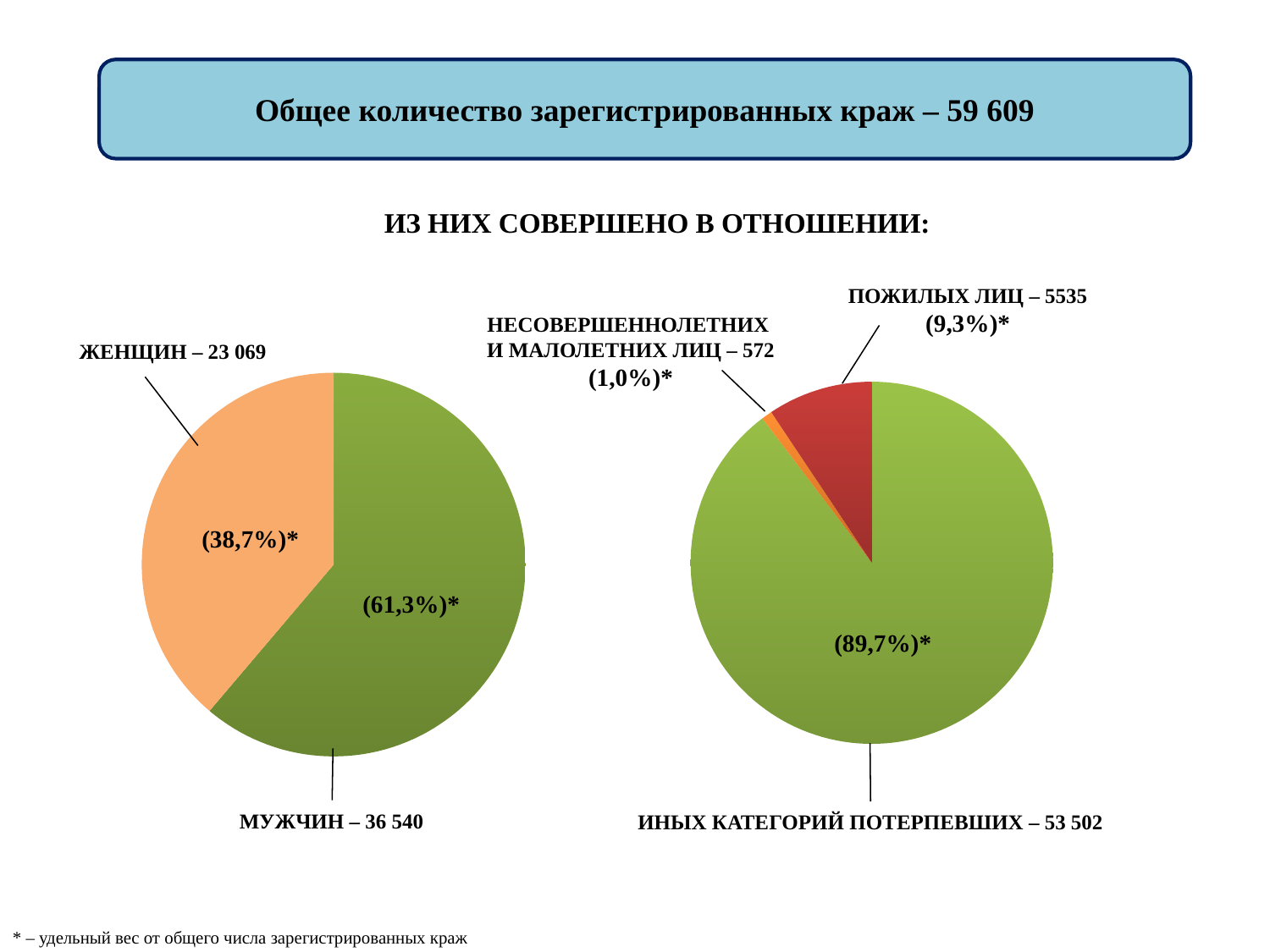
On the left pie chart, how many thefts were committed against women (ЖЕНЩИН)? 23 069 What type of chart is used on the left side of the slide? Pie chart On the left pie chart, how many thefts were committed against men (МУЖЧИН)? 36 540 On the left pie chart, what is the difference between the number of thefts against men (МУЖЧИН) and against women (ЖЕНЩИН)? 13 471 On the right pie chart, what share of the total do thefts against other categories of victims (ИНЫХ КАТЕГОРИЙ ПОТЕРПЕВШИХ) represent? 89,7% On the right pie chart, how many categories are shown? 3 On the right pie chart, how many thefts were committed against elderly persons (ПОЖИЛЫХ ЛИЦ)? 5535 On the right pie chart, which category has the smallest value? НЕСОВЕРШЕННОЛЕТНИХ И МАЛОЛЕТНИХ ЛИЦ On the right pie chart, how many thefts were committed against minors (НЕСОВЕРШЕННОЛЕТНИХ И МАЛОЛЕТНИХ ЛИЦ)? 572 On the left pie chart, which category has the larger value, ЖЕНЩИН or МУЖЧИН? МУЖЧИН On the left pie chart, what share of the total do thefts against women (ЖЕНЩИН) represent? 38,7% On the left pie chart, what share of the total do thefts against men (МУЖЧИН) represent? 61,3%